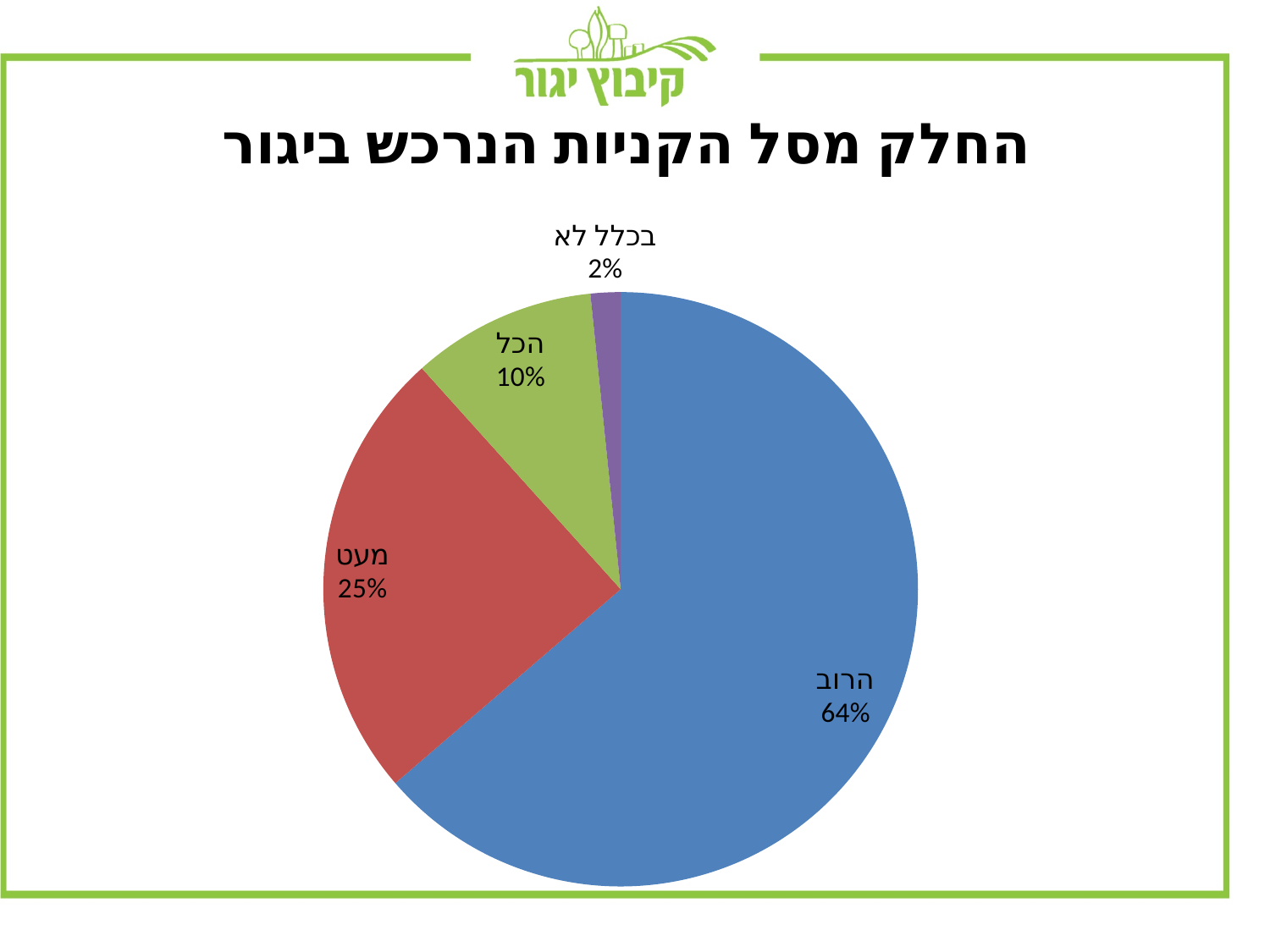
What percentage is shown for the slice labelled הרוב? 64% What is the difference in percentage points between the הרוב slice and the מעט slice? 39 What percentage is shown for the slice labelled מעט? 25% What colour is the slice labelled הרוב? blue Which slice is the smallest? בכלל לא Which slice is larger, הכל or מעט? מעט What percentage is shown for the slice labelled בכלל לא? 2% What percentage is shown for the slice labelled הכל? 10% Which slice is the largest? הרוב What is the title of the chart? החלק מסל הקניות הנרכש ביגור What kind of chart is shown on the slide? pie chart How many slices does the pie chart have? 4